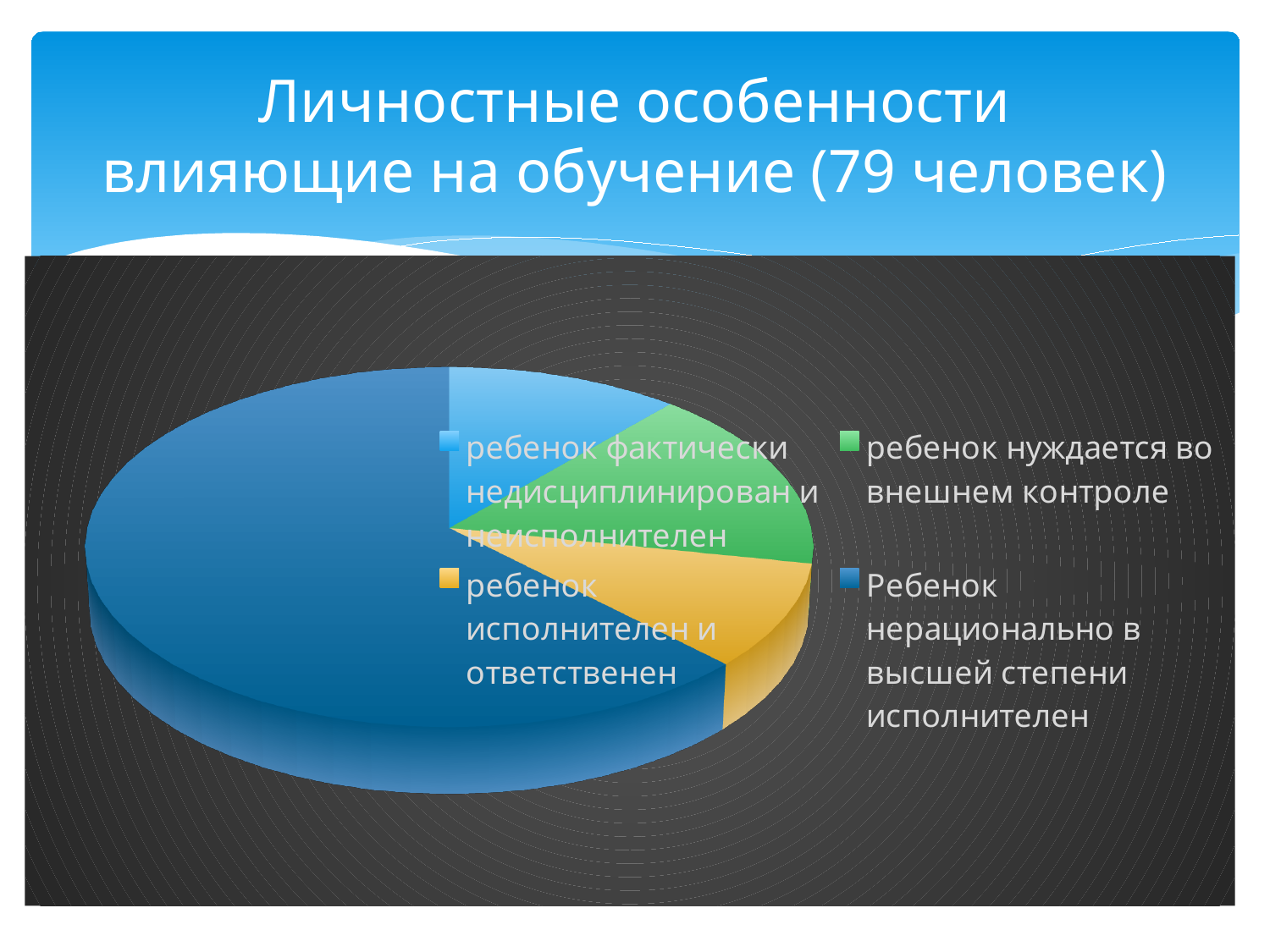
How many entries does the legend of the pie chart list? 4 What colour is the slice for 'ребенок нуждается во внешнем контроле'? green Which slice is larger: 'Ребенок нерационально в высшей степени исполнителен' or 'ребенок исполнителен и ответственен'? Ребенок нерационально в высшей степени исполнителен Which slice is larger: 'ребенок нуждается во внешнем контроле' or 'ребенок фактически недисциплинирован и неисполнителен'? ребенок нуждается во внешнем контроле Does the slice for 'Ребенок нерационально в высшей степени исполнителен' take up more or less than half of the pie? more Which category has the largest slice of the pie chart? Ребенок нерационально в высшей степени исполнителен How many slices does the pie chart have? 4 Which category has the smallest slice of the pie chart? ребенок исполнителен и ответственен What is the title of the chart slide? Личностные особенности влияющие на обучение (79 человек) What kind of chart is shown on the slide? pie chart